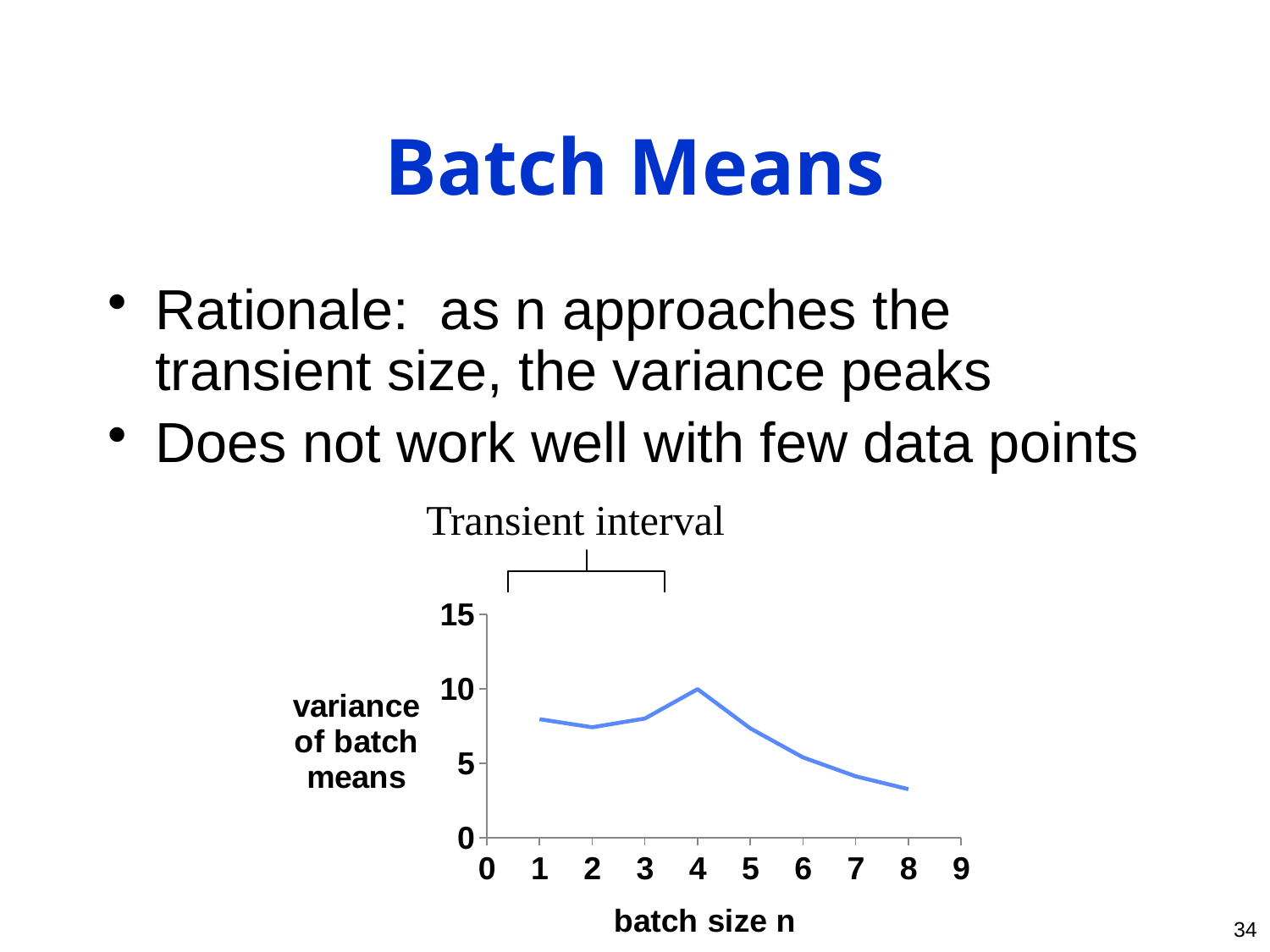
Which has the larger variance of batch means: batch size n = 4 or batch size n = 8? batch size n = 4 What kind of chart is shown on the slide? line chart Do the values rise or fall as batch size n increases from 4 to 8? fall Is the variance of batch means at batch size n = 2 greater or less than 10? less At which batch size n does the variance of batch means reach its highest value? 4 At which batch size n is the variance of batch means lowest? 8 How many data points are plotted on the line? 8 What is the label on the x axis of the chart? batch size n Is the variance of batch means at batch size n = 7 greater or less than 5? less Is the variance of batch means at batch size n = 1 greater or less than 5? greater